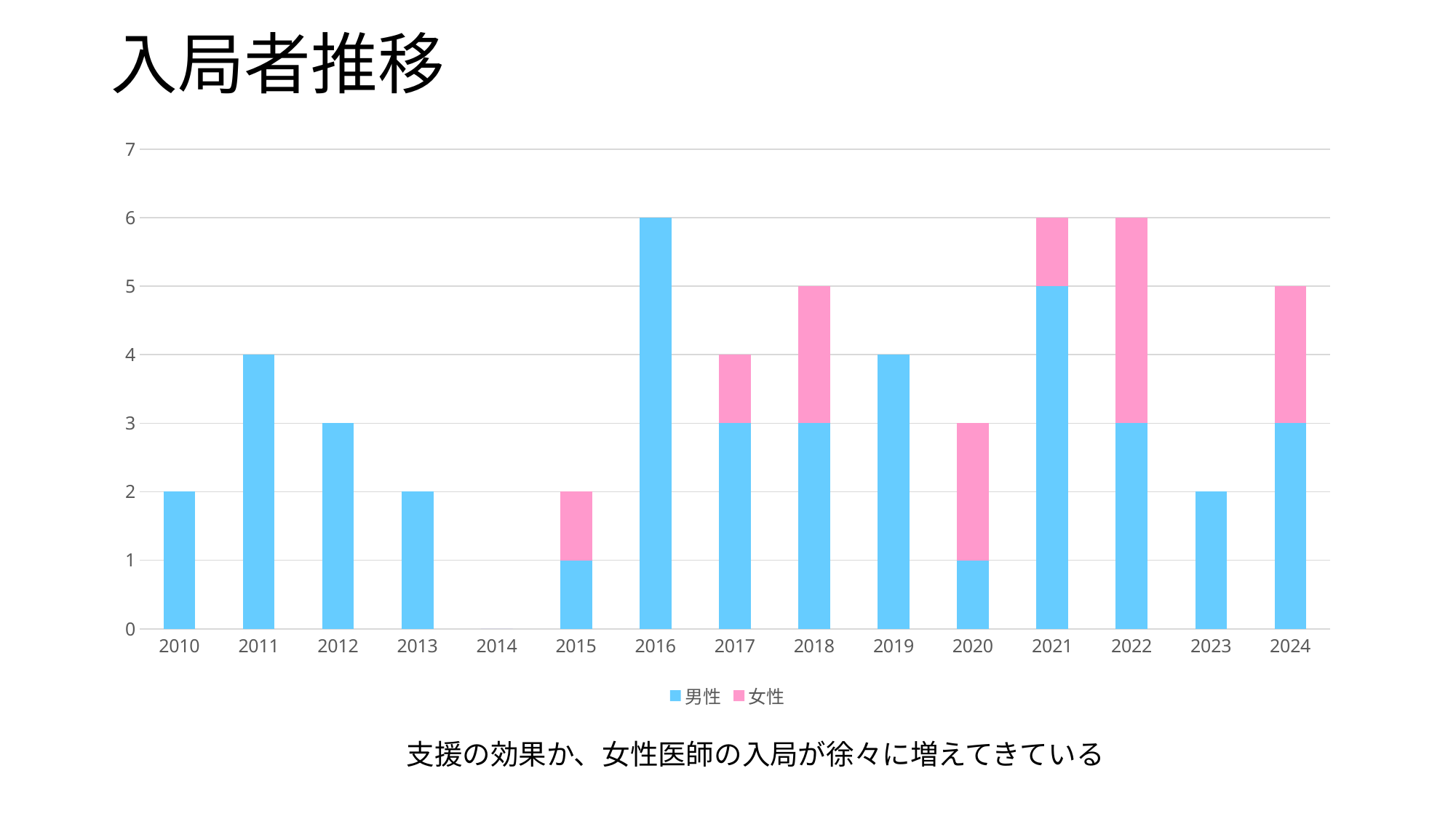
Which year has the highest value for 男性? 2016 What is the value for 女性 in 2022? 3 How many series does the legend list? 2 What is the value for 男性 in 2016? 6 What kind of chart is shown on the slide? Stacked bar chart Which year has the lowest total number of entrants? 2014 Which year has the highest value for 女性? 2022 How many years are shown on the x axis? 15 Which year has a larger total, 2011 or 2012? 2011 What is the value for 男性 in 2021? 5 What is the difference between the 男性 value in 2016 and the 男性 value in 2023? 4 What is the total of the stacked bar for 2018? 5